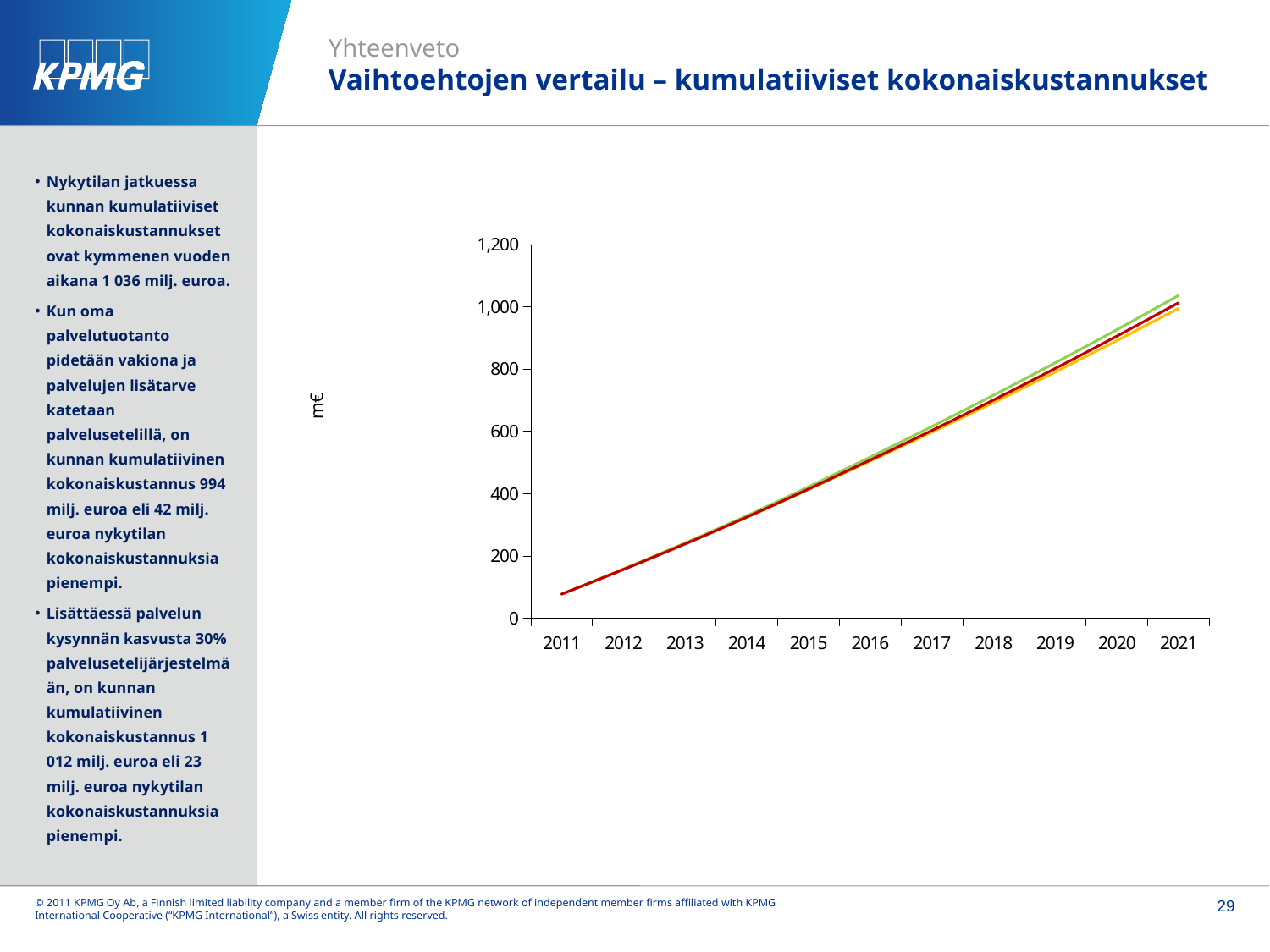
In which year do the lines have their lowest value? 2011 Is the value of the green line in 2021 greater or less than 800? greater What is the label on the y axis of the chart? m€ Do the values on the chart rise or fall from 2011 to 2021? rise Is the value of the lines in 2016 greater or less than 600? less In 2021, which line is higher, the green line or the yellow line? green line Is the value of the lines in 2011 greater or less than 200? less What kind of chart is shown on the slide? line chart In which year do the lines reach their highest value? 2021 How many lines are plotted on the chart? 3 How many years are shown on the x axis of the chart? 11